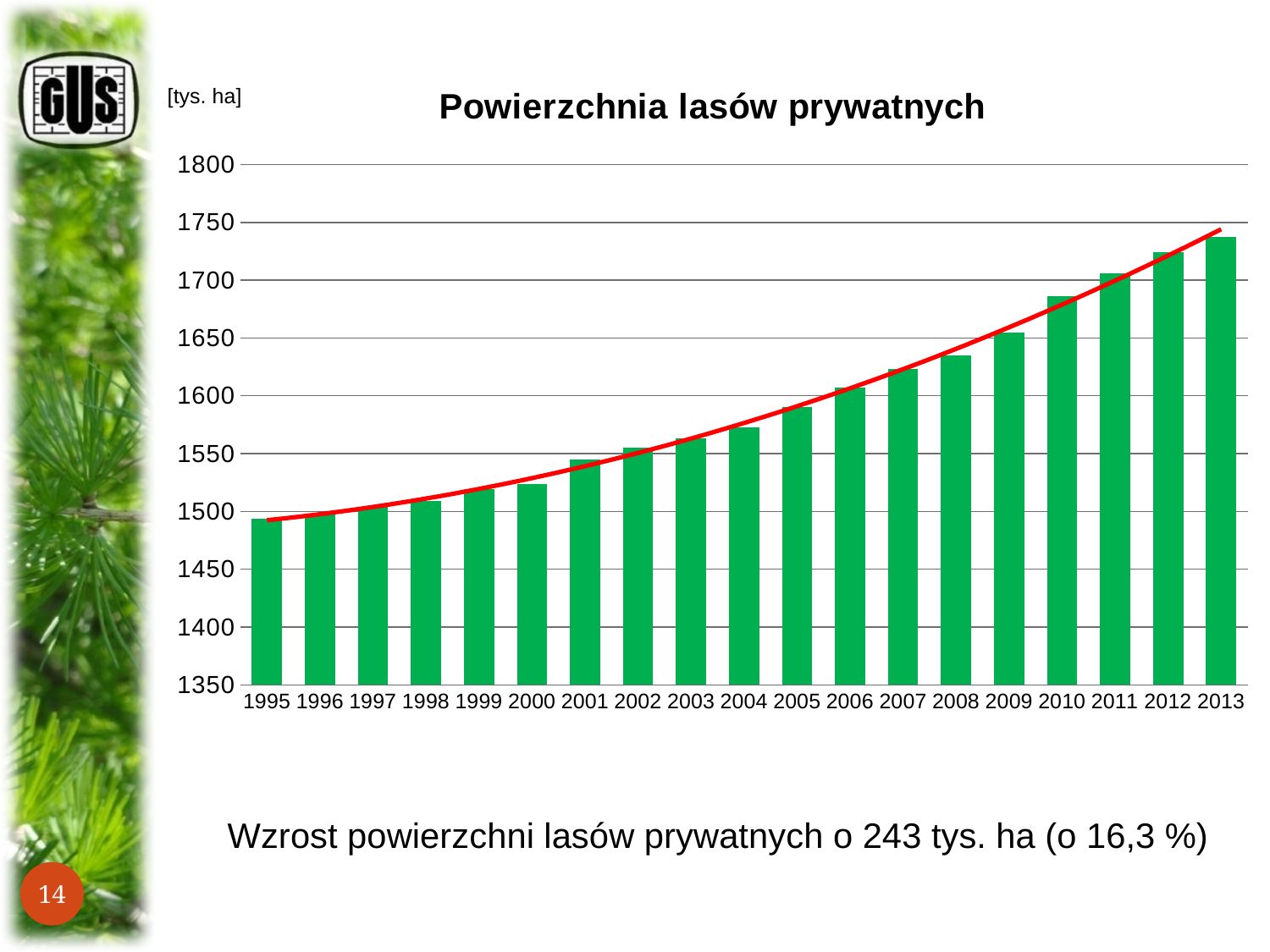
Which is larger, the value for 2008 or the value for 2003? 2008 Which year has the lowest value on the chart? 1995 Is the value for 2013 greater or less than 1700? greater How many years (bars) are plotted on the chart? 19 Is the value for 2000 greater or less than 1550? less What kind of chart is shown on the slide? bar chart Is the value for 2004 greater or less than 1550? greater What unit is shown for the values on the chart? tys. ha What is the title of the chart? Powierzchnia lasów prywatnych Do the values rise or fall from 1995 to 2013? rise Which year has the highest value on the chart? 2013